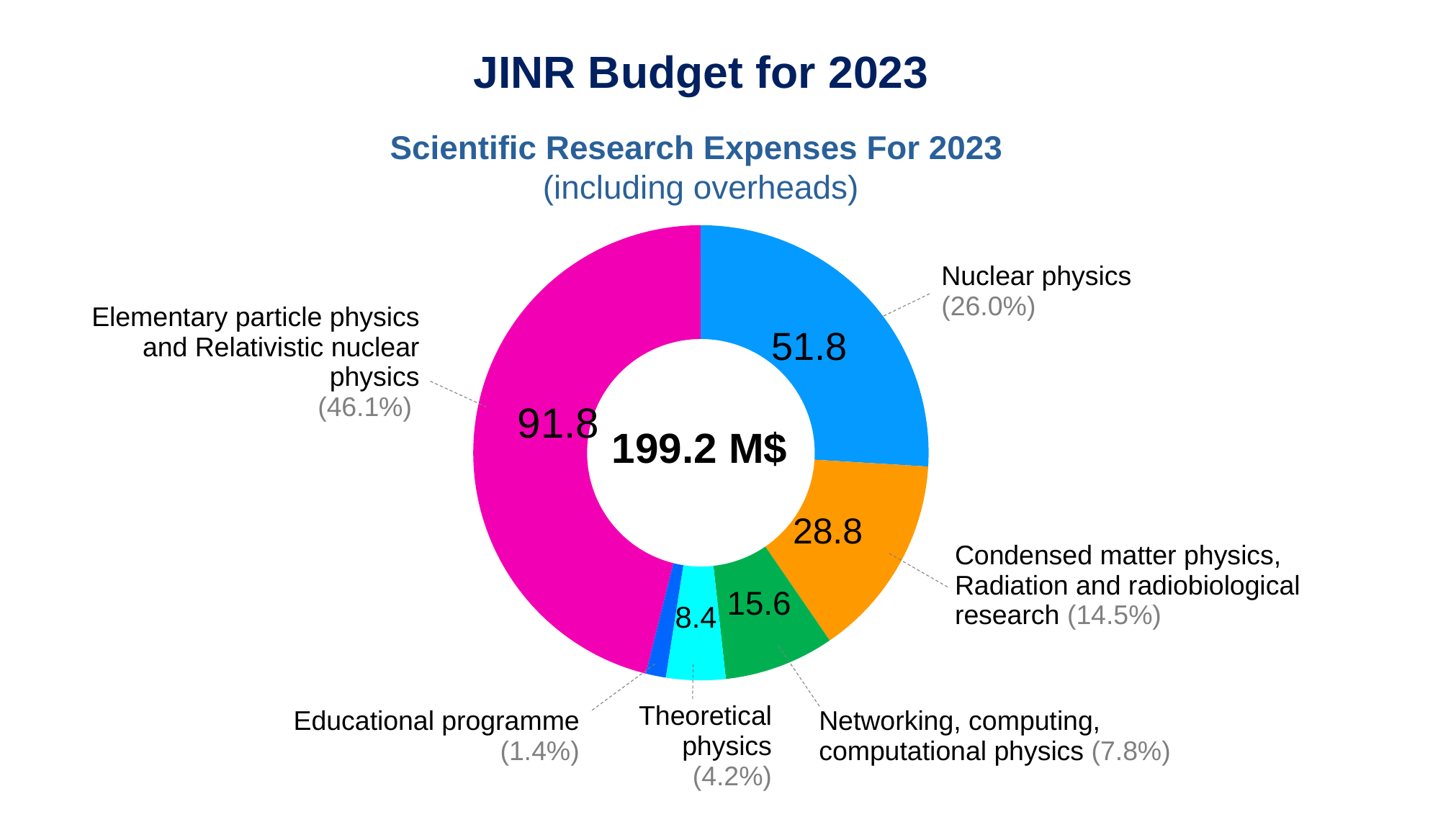
Which category has the largest slice? Elementary particle physics and Relativistic nuclear physics What is the value for Nuclear physics? 51.8 Which category has the smallest slice? Educational programme What is the value for Elementary particle physics and Relativistic nuclear physics? 91.8 Which is larger, the value for Networking, computing, computational physics or the value for Theoretical physics? Networking, computing, computational physics What total is shown in the centre of the chart? 199.2 M$ How many categories does the chart show? 6 What share of the chart does Networking, computing, computational physics represent? 7.8% What is the difference between the values for Nuclear physics and Condensed matter physics, Radiation and radiobiological research? 23.0 What is the value for Condensed matter physics, Radiation and radiobiological research? 28.8 What share of the chart does Educational programme represent? 1.4% What is the value for Theoretical physics? 8.4